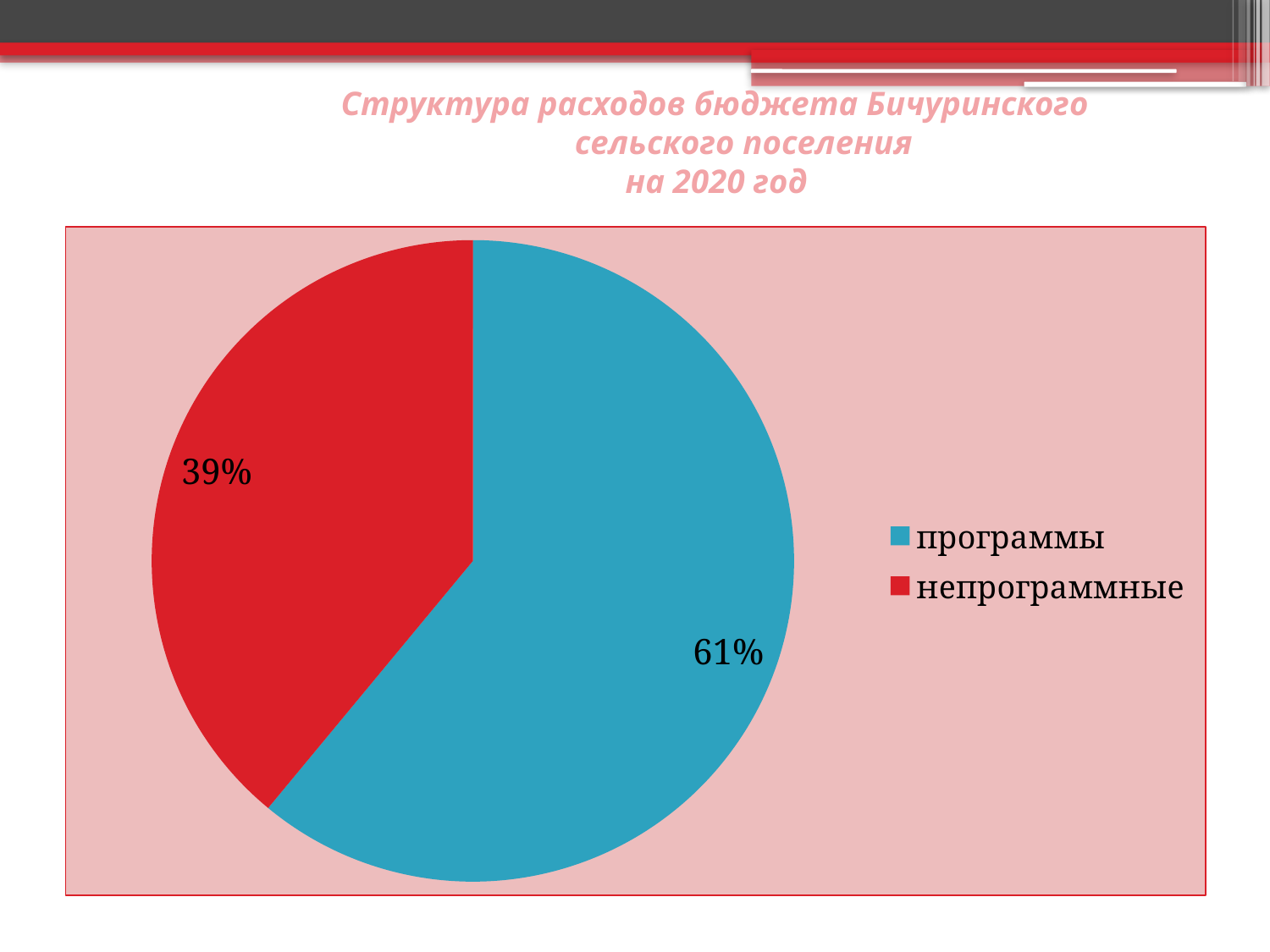
What is the difference in percentage points between the "программы" and "непрограммные" slices? 22% What share of the pie does the "непрограммные" slice have? 39% What share of the pie does the "программы" slice have? 61% What colour is the "программы" slice? blue What kind of chart is shown on the slide? pie chart Which is larger, the share for "программы" or for "непрограммные"? программы Which category has the largest slice of the pie? программы Which category has the smallest slice of the pie? непрограммные What colour is the "непрограммные" slice? red How many slices does the pie chart have? 2 How many entries does the legend list? 2